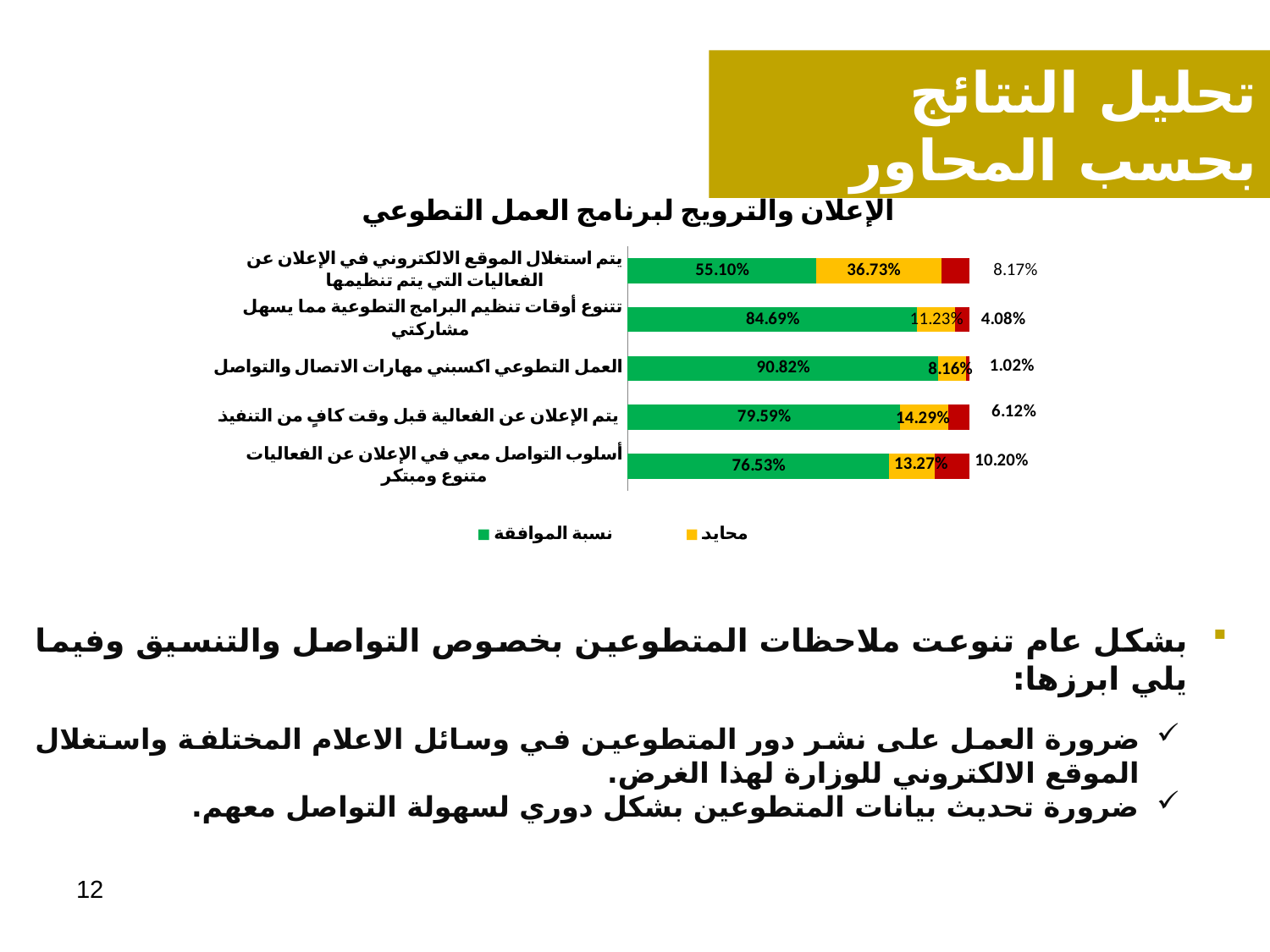
What type of chart is shown on the slide? Stacked bar chart What is the agreement rate (نسبة الموافقة) for "يتم الإعلان عن الفعالية قبل وقت كافٍ من التنفيذ"? 79.59% What is the difference between the agreement rates of "تنوع أوقات تنظيم البرامج التطوعية مما يسهل مشاركتي" and "أسلوب التواصل معي في الإعلان عن الفعاليات متنوع ومبتكر"? 8.16% How many categories are shown in the chart? 5 What is the agreement rate (نسبة الموافقة) for "العمل التطوعي اكسبني مهارات الاتصال والتواصل"? 90.82% What is the neutral (محايد) value for "يتم استغلال الموقع الالكتروني في الإعلان عن الفعاليات التي يتم تنظيمها"? 36.73% What is the title of the chart? الإعلان والترويج لبرنامج العمل التطوعي What is the value of the red segment for "أسلوب التواصل معي في الإعلان عن الفعاليات متنوع ومبتكر"? 10.20% Which category has the lowest agreement rate (نسبة الموافقة)? يتم استغلال الموقع الالكتروني في الإعلان عن الفعاليات التي يتم تنظيمها Which has a larger neutral (محايد) value: "يتم الإعلان عن الفعالية قبل وقت كافٍ من التنفيذ" or "العمل التطوعي اكسبني مهارات الاتصال والتواصل"? يتم الإعلان عن الفعالية قبل وقت كافٍ من التنفيذ Which colour represents نسبة الموافقة in the chart? Green Which category has the highest agreement rate (نسبة الموافقة)? العمل التطوعي اكسبني مهارات الاتصال والتواصل